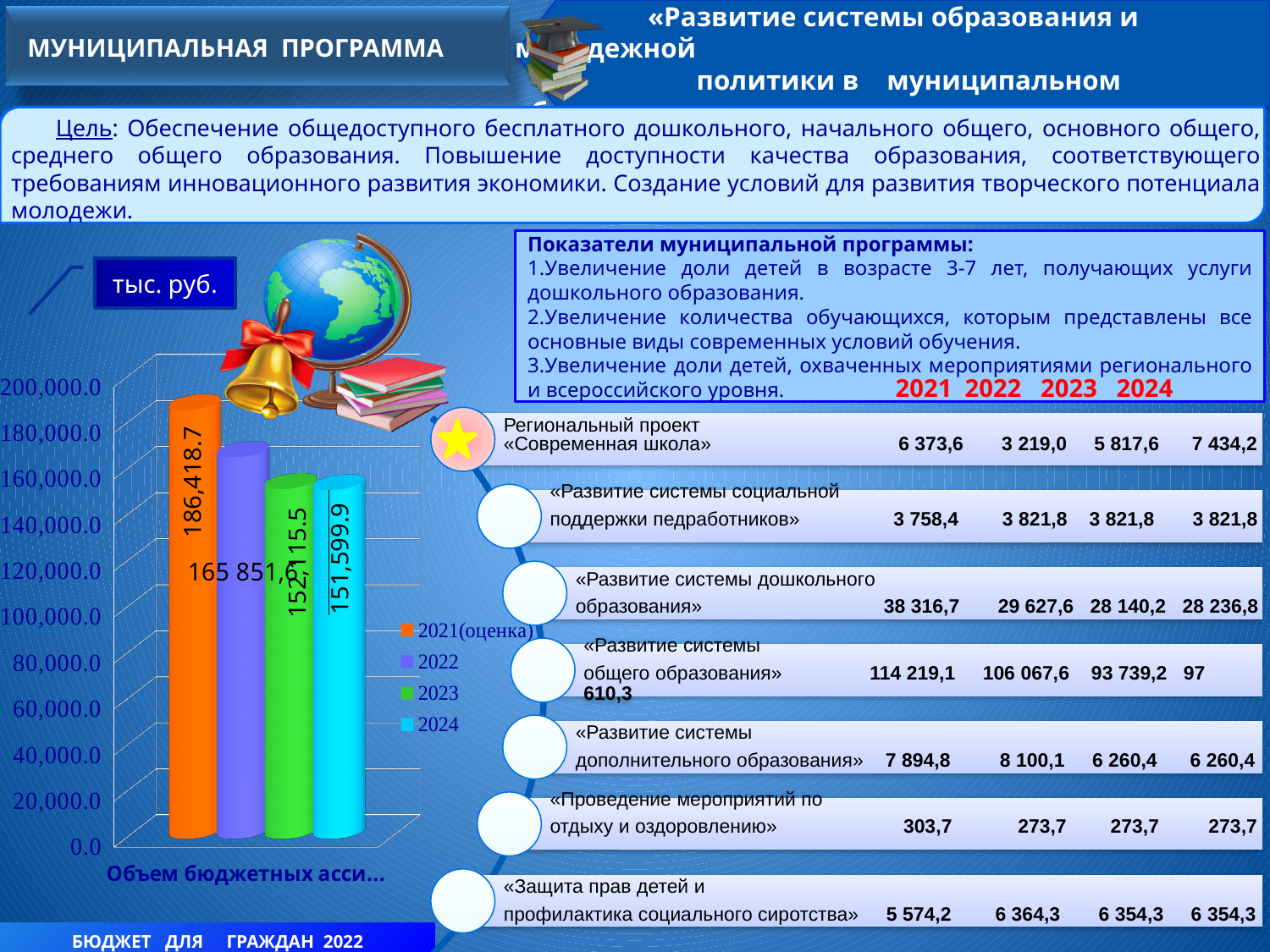
Which year has the highest value in the bar chart? 2021(оценка) What is the value for 2023 in the bar chart? 152,115.5 What is the difference between the 2023 value and the 2024 value in the bar chart? 515.6 Which year has the lowest value in the bar chart? 2024 What is the difference between the 2021(оценка) value and the 2023 value in the bar chart? 34,303.2 What is the value for 2024 in the bar chart? 151,599.9 Is the value for 2022 in the bar chart greater or less than 140,000.0? greater How many series does the legend of the bar chart list? 4 Do the values in the bar chart rise or fall from 2021(оценка) to 2024? fall What kind of chart is shown on the slide? bar chart What is the value for 2021(оценка) in the bar chart? 186,418.7 Which is larger in the bar chart, the value for 2021(оценка) or the value for 2022? 2021(оценка)